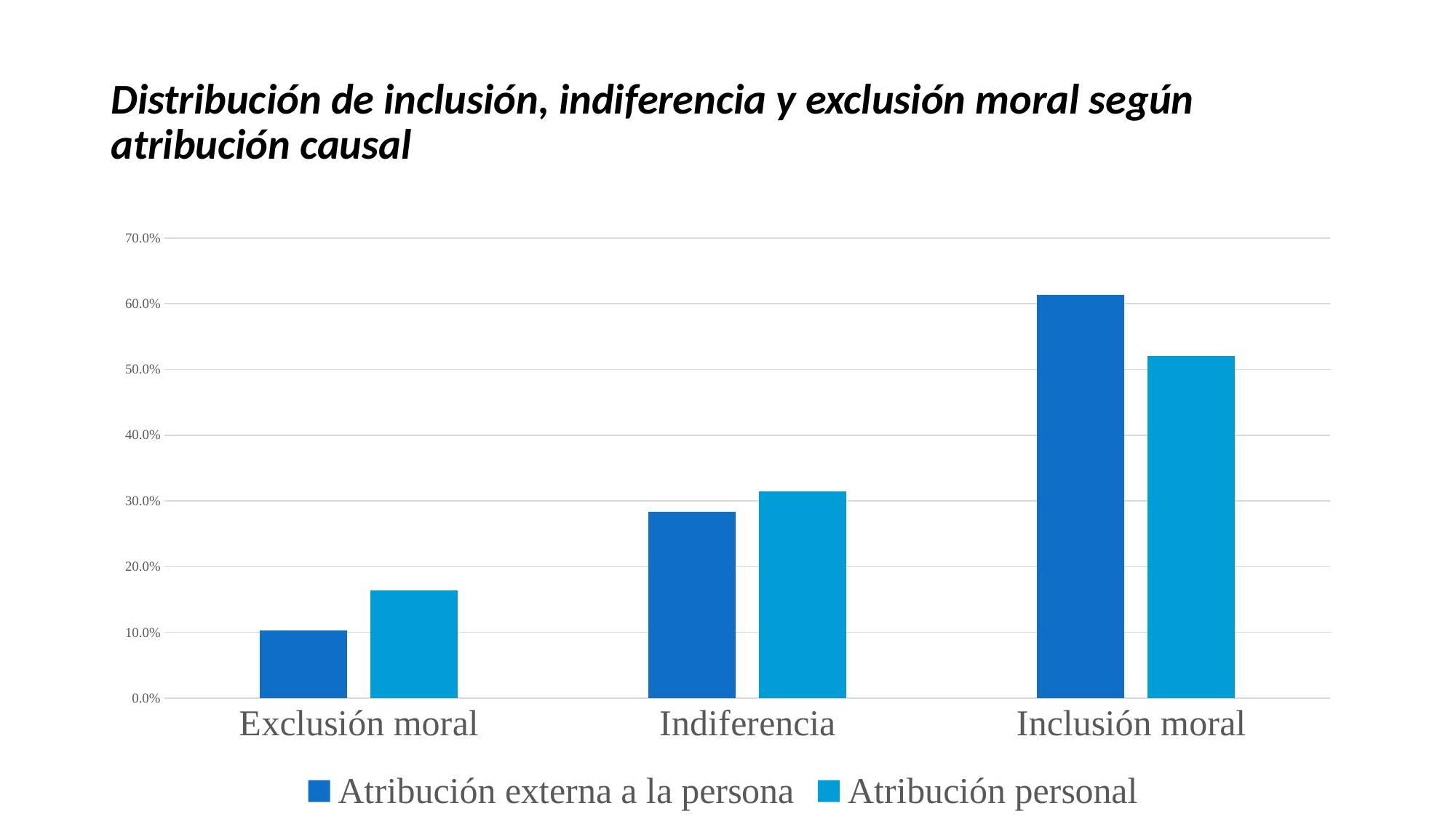
How many series does the legend list? 2 How many categories are shown on the x axis of the chart? 3 Which category has the lowest value for Atribución personal? Exclusión moral Is the value for Atribución personal in Indiferencia greater or less than 30.0%? greater Is the value for Atribución externa a la persona in Inclusión moral greater or less than 60.0%? greater Do the values for Atribución personal rise or fall from Exclusión moral to Inclusión moral? rise For Inclusión moral, which series has the larger value: Atribución externa a la persona or Atribución personal? Atribución externa a la persona For Exclusión moral, which series has the larger value: Atribución externa a la persona or Atribución personal? Atribución personal Which category has the highest value for Atribución externa a la persona? Inclusión moral Which category has the lowest value for Atribución externa a la persona? Exclusión moral Is the value for Atribución personal in Exclusión moral greater or less than 20.0%? less What kind of chart is shown on the slide? bar chart